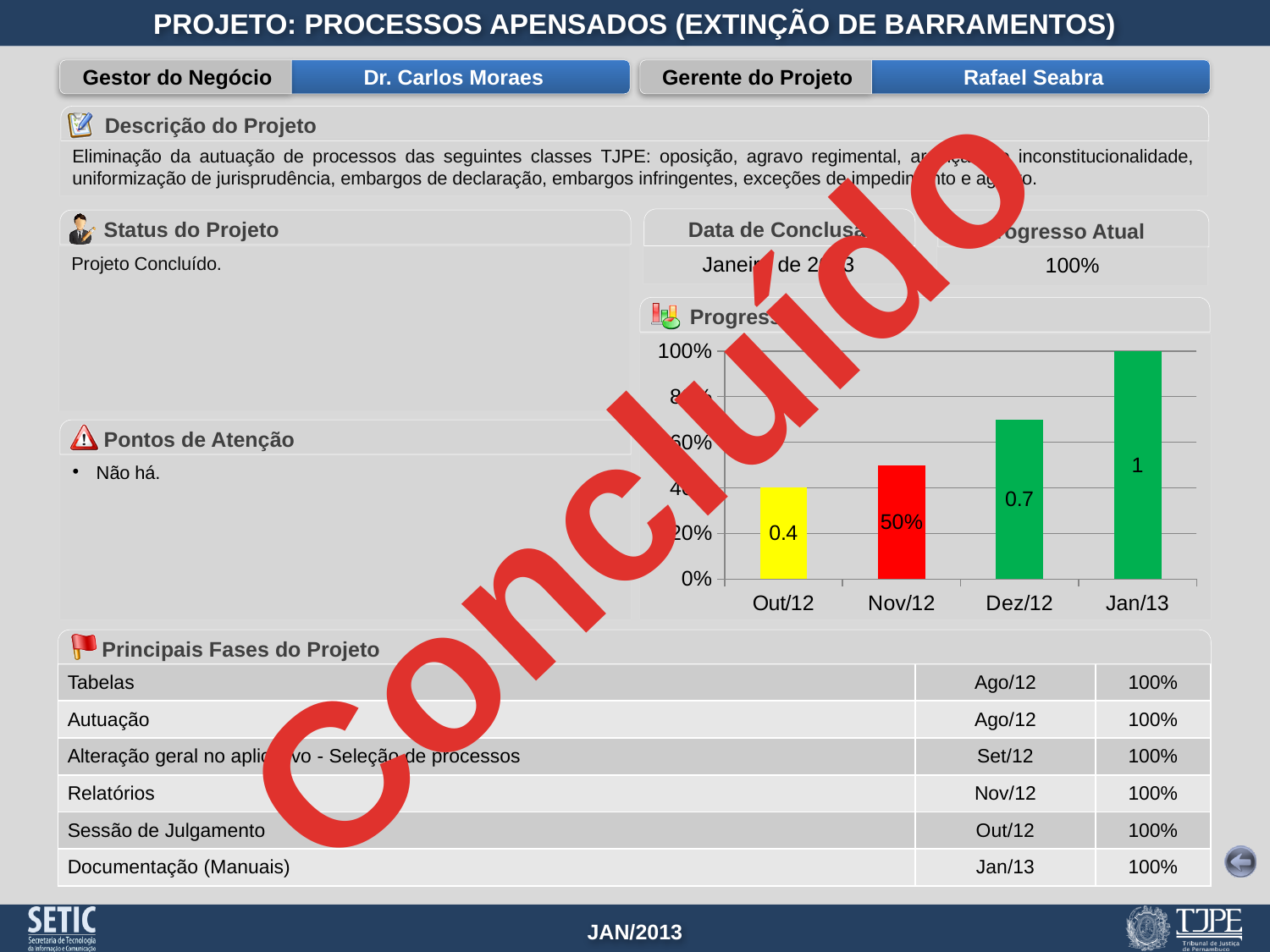
Which month has the highest bar in the chart? Jan/13 Which bar is taller, Dez/12 or Nov/12? Dez/12 What value is labelled on the bar for Dez/12? 0.7 What value is labelled on the bar for Nov/12? 50% What colour is the bar for Nov/12? Red Which month has the lowest bar in the chart? Out/12 What value is labelled on the bar for Jan/13? 1 Do the bar values rise or fall from Out/12 to Jan/13? Rise What value is labelled on the bar for Out/12? 0.4 What is the difference between the labelled values for Dez/12 and Out/12? 0.3 What kind of chart is shown on the slide? Bar chart How many months are shown on the x axis of the chart? 4